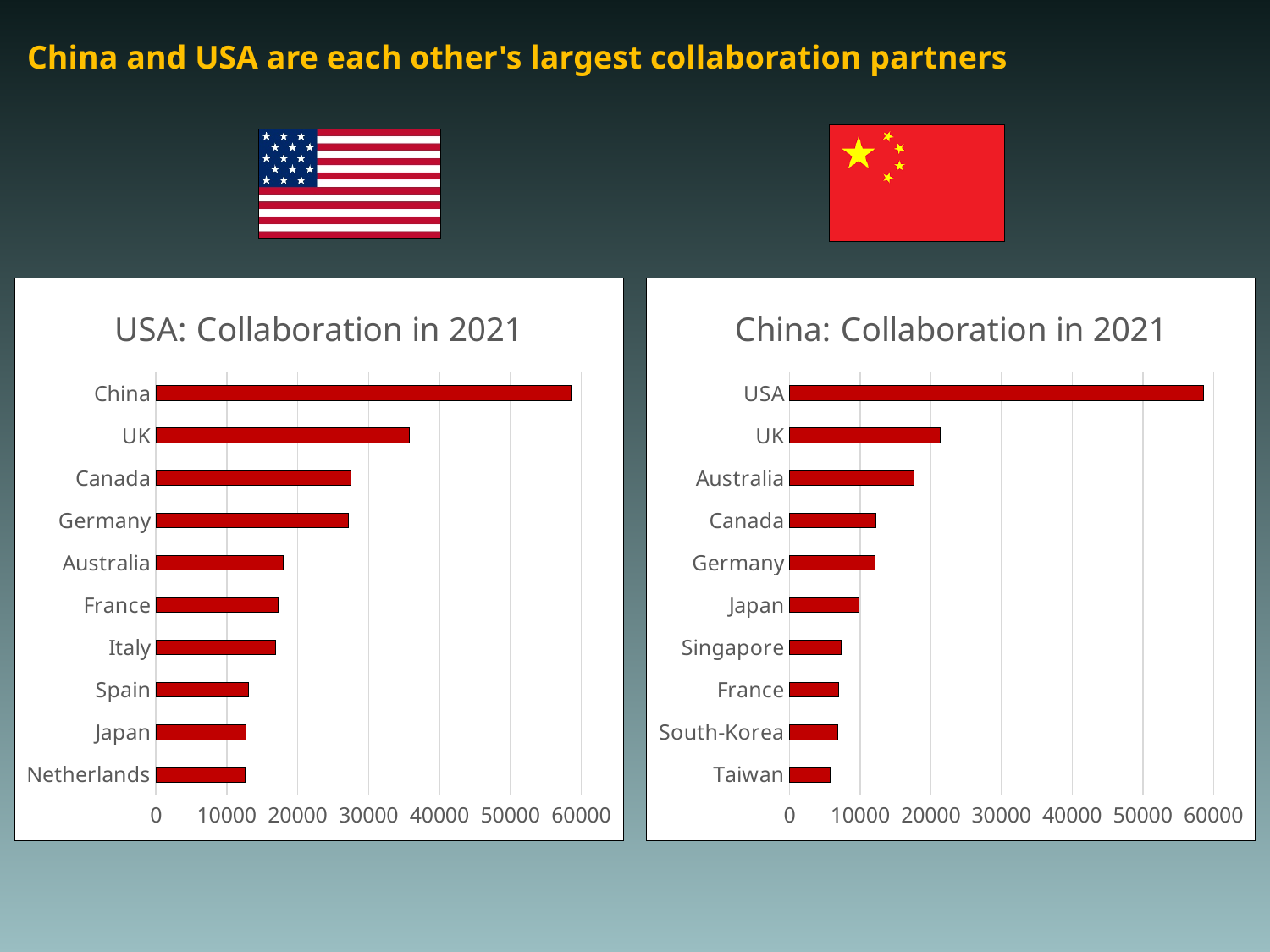
In the 'China: Collaboration in 2021' chart, is the value for Japan greater or less than 20000? less In the 'China: Collaboration in 2021' chart, which country has the lowest value? Taiwan How many countries are shown in the 'USA: Collaboration in 2021' chart? 10 What is the title of the chart on the left side of the slide? USA: Collaboration in 2021 In the 'China: Collaboration in 2021' chart, is the value for UK greater or less than 20000? greater In the 'USA: Collaboration in 2021' chart, is the value for Australia greater or less than 20000? less In the 'China: Collaboration in 2021' chart, which country has the highest value? USA In the 'USA: Collaboration in 2021' chart, which is larger, the value for UK or the value for Canada? UK In the 'China: Collaboration in 2021' chart, which is larger, the value for Australia or the value for Japan? Australia What kind of chart is the 'China: Collaboration in 2021' chart? Bar chart In the 'USA: Collaboration in 2021' chart, which country has the highest value? China